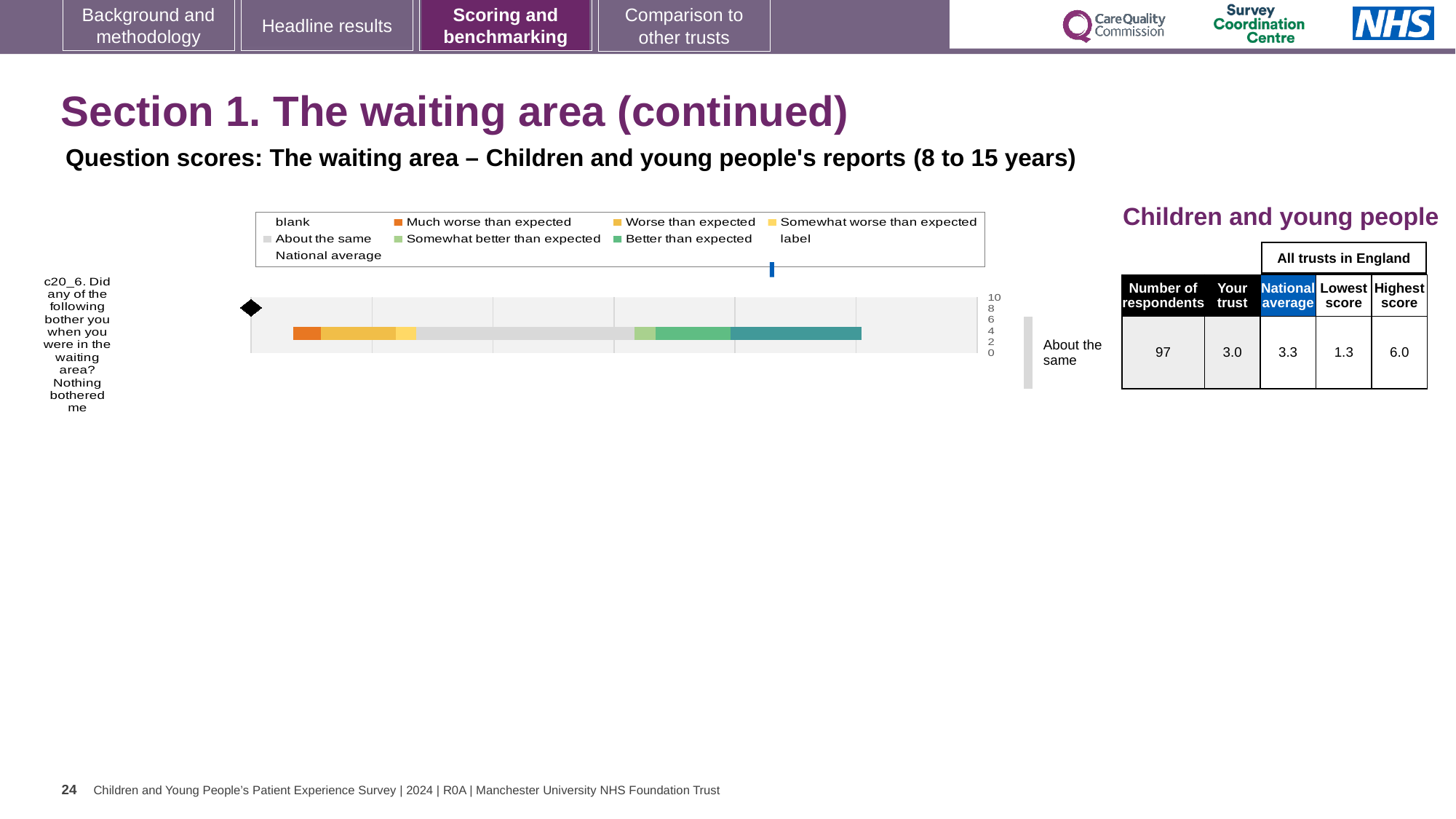
Which legend entry is shown in dark teal? Better than expected Which is larger for question c20_6: the 'Your trust' score or the national average? National average What kind of chart is shown on the slide? Bar chart What colour represents 'Much worse than expected' in the chart legend? Orange What is the lowest score across all trusts in England for question c20_6? 1.3 How many survey questions (categories) are plotted in the chart? 1 What is the 'Your trust' score for question c20_6 in the table? 3.0 What is the difference between the highest score and the lowest score for question c20_6? 4.7 What is the national average score for question c20_6 in the table? 3.3 What is the highest score across all trusts in England for question c20_6? 6.0 How many entries does the chart legend list? 9 How many respondents are listed for question c20_6? 97